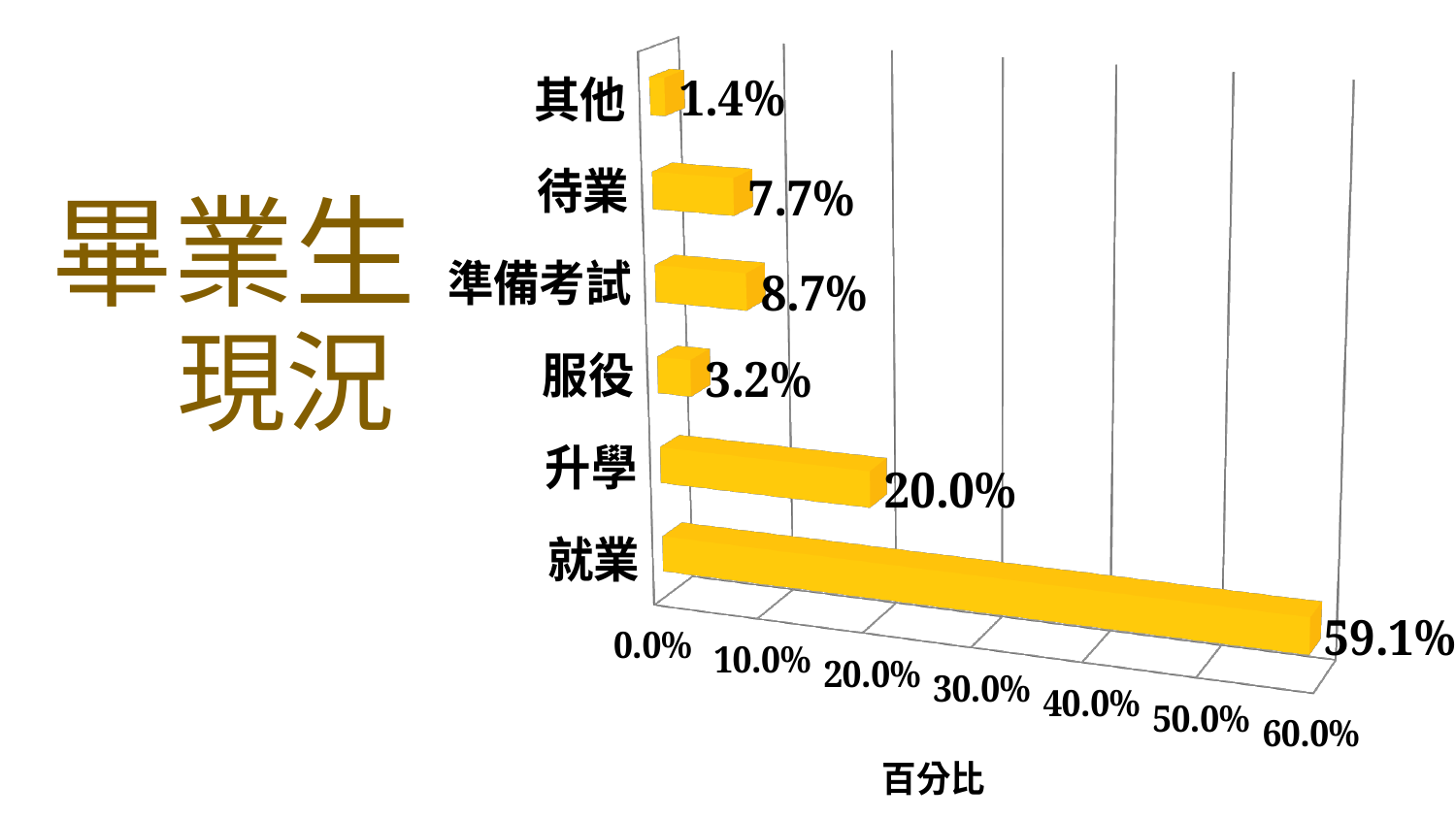
What is the difference between the values for 就業 and 升學? 39.1% What is the difference between the values for 準備考試 and 待業? 1.0% Which category has the highest value? 就業 What is the value for 升學? 20.0% What is the value for 服役? 3.2% What is the label of the horizontal axis? 百分比 What is the value for 準備考試? 8.7% What is the value for 就業? 59.1% Which is larger, the value for 待業 or the value for 服役? 待業 How many categories are shown in the chart? 6 Which category has the lowest value? 其他 What kind of chart is shown on the slide? bar chart